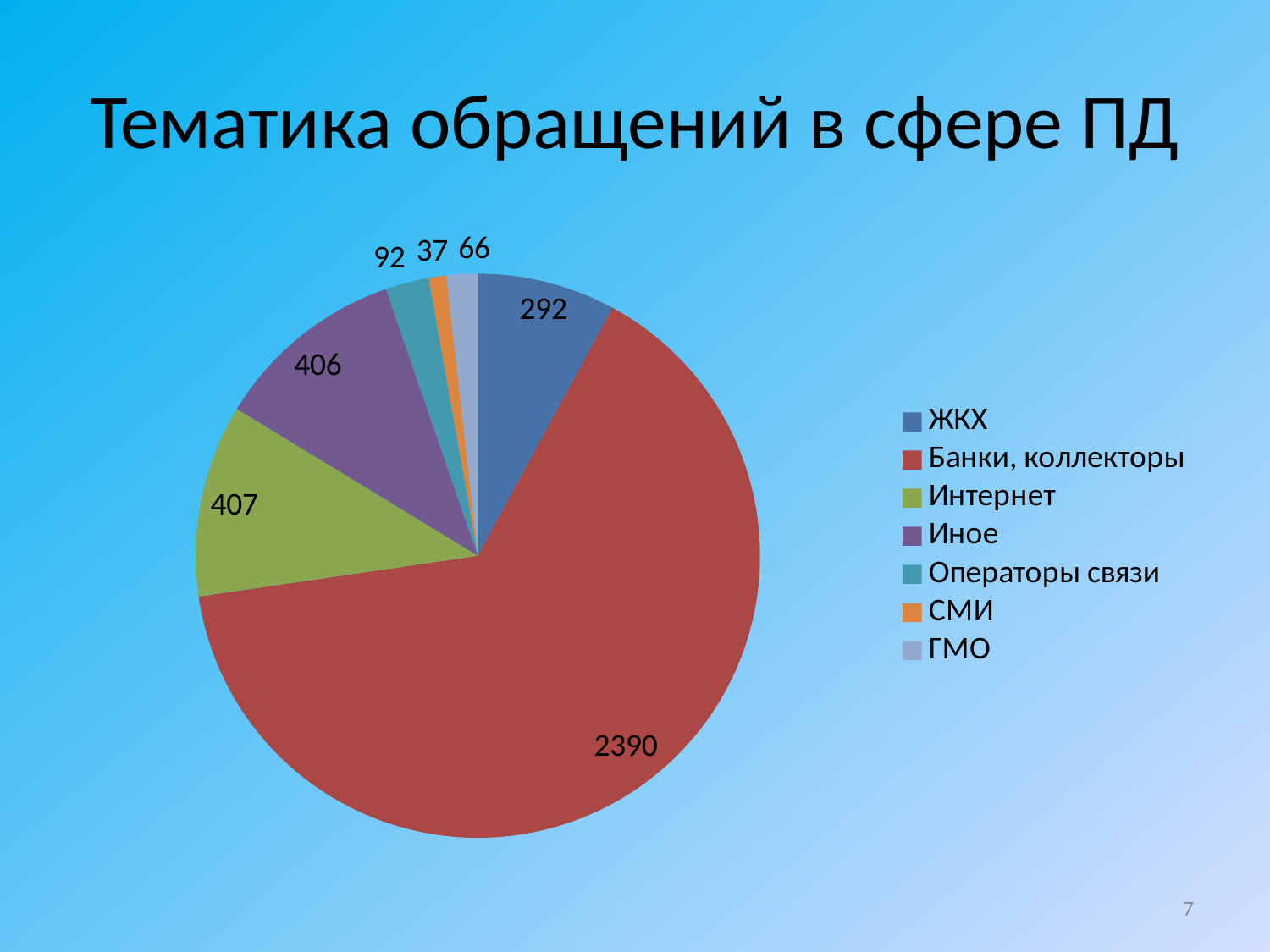
Which category has the smallest slice of the pie? СМИ What is the value for ЖКХ? 292 Which is larger, the value for ЖКХ or the value for Операторы связи? ЖКХ What is the value for ГМО? 66 What is the difference between the values for Банки, коллекторы and ЖКХ? 2098 How many categories does the pie chart have? 7 What kind of chart is shown on the slide? pie chart What is the value for Банки, коллекторы? 2390 Which category has the largest slice of the pie? Банки, коллекторы What is the title of the slide containing the chart? Тематика обращений в сфере ПД What is the difference between the values for Интернет and Иное? 1 What is the value for Операторы связи? 92